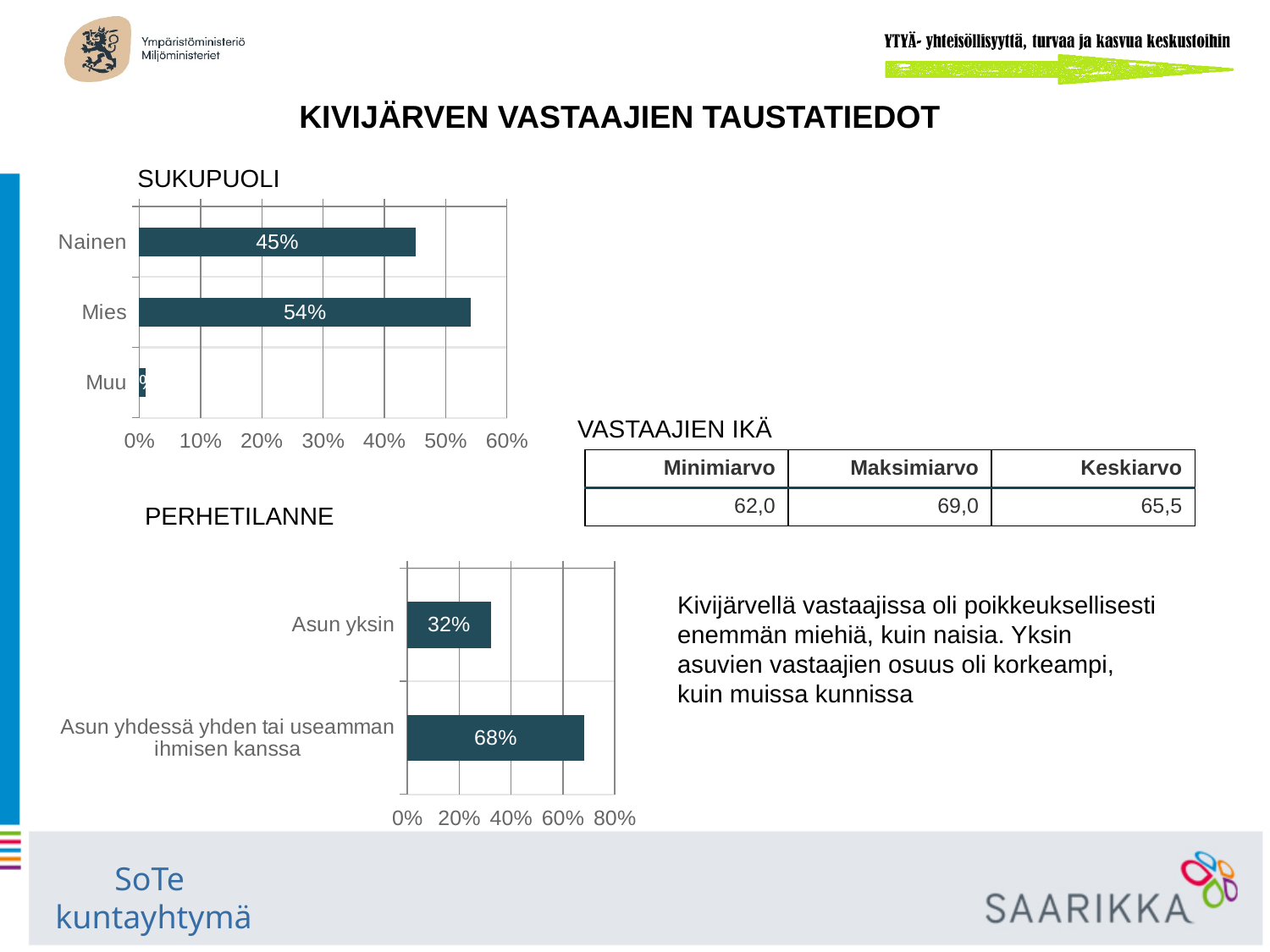
In the PERHETILANNE chart, which category is larger: Asun yksin or Asun yhdessä yhden tai useamman ihmisen kanssa? Asun yhdessä yhden tai useamman ihmisen kanssa In the PERHETILANNE chart, what is the value for Asun yksin? 32% What type of chart is the PERHETILANNE chart? Bar chart In the SUKUPUOLI chart, which category has the lowest value? Muu In the SUKUPUOLI chart, what is the difference between the values for Mies and Nainen? 9% In the PERHETILANNE chart, what is the value for Asun yhdessä yhden tai useamman ihmisen kanssa? 68% How many categories are shown in the SUKUPUOLI chart? 3 In the SUKUPUOLI chart, which category has the highest value? Mies In the SUKUPUOLI chart, what is the value for Nainen? 45% In the SUKUPUOLI chart, what is the value for Mies? 54% In the PERHETILANNE chart, what is the difference between the two values? 36% In the SUKUPUOLI chart, is the value for Muu greater or less than 10%? less